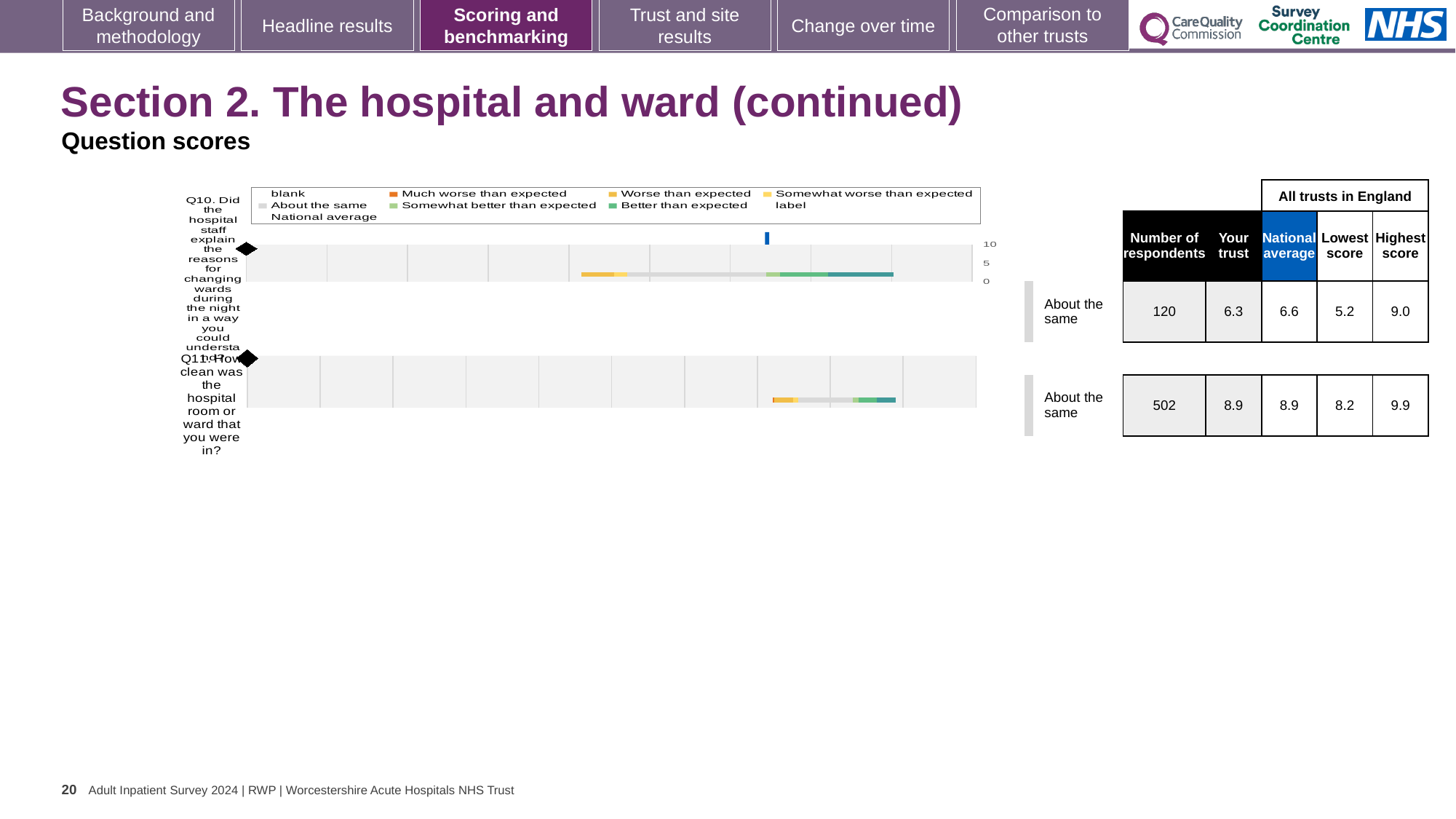
What is the number of respondents for Q10 (explaining reasons for changing wards during the night)? 120 For Q10, which is larger: the 'Your trust' score or the national average? National average What is the 'Your trust' score for Q11 (how clean was the hospital room or ward)? 8.9 What is the highest score among all trusts in England for Q11? 9.9 What is the difference between the highest and lowest scores for Q11? 1.7 What benchmark category is shown for Q11 on this slide? About the same What kind of chart is used to show the question scores on this slide? bar chart How many questions are plotted on the chart on this slide? 2 Which question has the higher 'Your trust' score, Q10 or Q11? Q11 What is the national average score for Q10? 6.6 What is the difference between the highest and lowest scores for Q10? 3.8 What is the lowest score among all trusts in England for Q10? 5.2